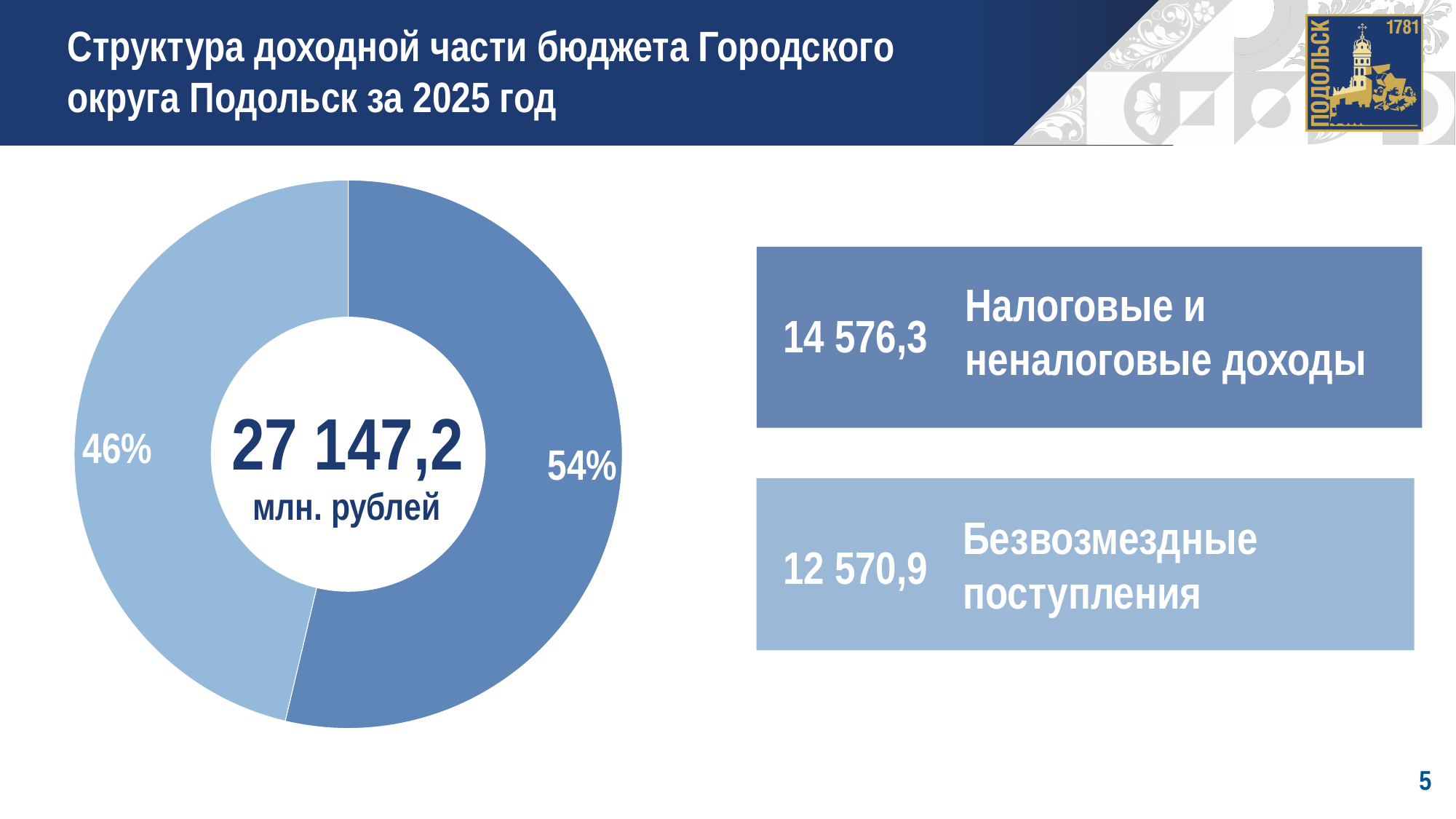
What share of the pie chart does the slice for Безвозмездные поступления represent? 46% What is the value shown for Налоговые и неналоговые доходы? 14 576,3 What is the value shown for Безвозмездные поступления? 12 570,9 How many slices does the pie chart have? 2 What share of the pie chart does the slice for Налоговые и неналоговые доходы represent? 54% Which is larger: Налоговые и неналоговые доходы or Безвозмездные поступления? Налоговые и неналоговые доходы What type of chart is shown on the slide? Pie (donut) chart What is the difference between the values for Налоговые и неналоговые доходы and Безвозмездные поступления? 2 005,4 Which category has the smallest share of the pie chart? Безвозмездные поступления What is the title of the slide containing the chart? Структура доходной части бюджета Городского округа Подольск за 2025 год What total value is shown in the centre of the donut chart? 27 147,2 млн. рублей Which category has the largest share of the pie chart? Налоговые и неналоговые доходы